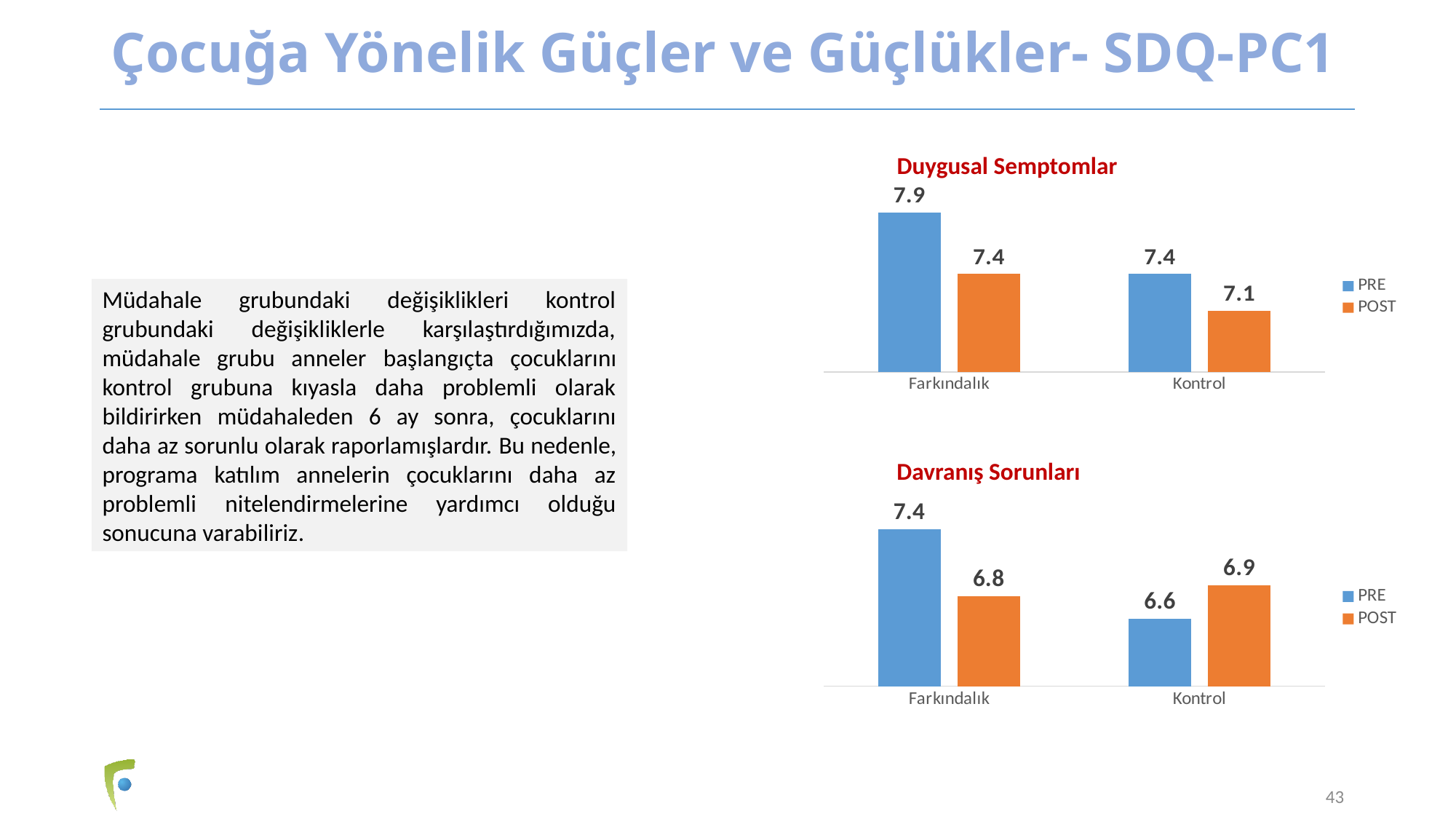
In the 'Duygusal Semptomlar' chart, which bar is the highest? Farkındalık PRE What kind of chart is the 'Duygusal Semptomlar' chart? Bar chart In the 'Davranış Sorunları' chart, which bar is the lowest? Kontrol PRE In the 'Duygusal Semptomlar' chart, what is the PRE value for Farkındalık? 7.9 In the 'Davranış Sorunları' chart, what is the difference between the PRE and POST values for Kontrol? 0.3 In the 'Davranış Sorunları' chart, what is the POST value for Farkındalık? 6.8 In the 'Duygusal Semptomlar' chart, what is the POST value for Kontrol? 7.1 In the 'Davranış Sorunları' chart, what is the PRE value for Kontrol? 6.6 How many categories are shown on the x axis of the 'Davranış Sorunları' chart? 2 In the 'Davranış Sorunları' chart, is the PRE or POST value larger for Kontrol? POST How many series does the legend of the 'Duygusal Semptomlar' chart list? 2 In the 'Duygusal Semptomlar' chart, what is the difference between the PRE and POST values for Farkındalık? 0.5